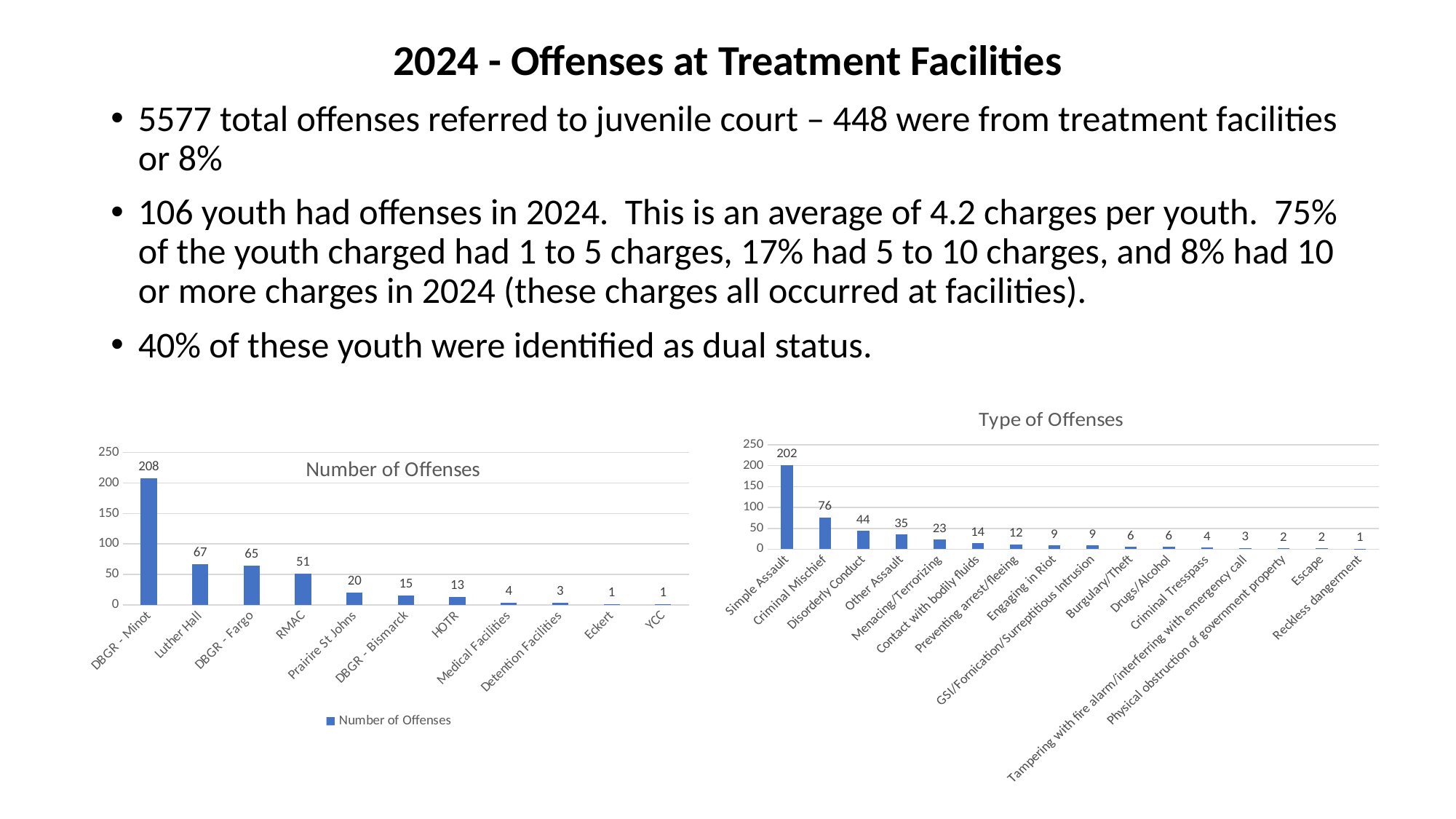
In the 'Type of Offenses' chart, which offense type has the lowest value? Reckless dangerment In the 'Number of Offenses' chart, which facility has the highest number of offenses? DBGR - Minot In the 'Number of Offenses' chart, how many series does the legend list? 1 In the 'Type of Offenses' chart, what is the difference between Simple Assault and Criminal Mischief? 126 In the 'Type of Offenses' chart, what is the value for Criminal Mischief? 76 In the 'Type of Offenses' chart, which is larger: Disorderly Conduct or Other Assault? Disorderly Conduct In the 'Number of Offenses' chart, how many facilities are shown on the x axis? 11 In the 'Number of Offenses' chart, what is the value for RMAC? 51 In the 'Type of Offenses' chart, what is the value for Menacing/Terrorizing? 23 In the 'Number of Offenses' chart, what is the value for DBGR - Minot? 208 In the 'Number of Offenses' chart, what is the difference between Luther Hall and DBGR - Fargo? 2 What kind of chart is the 'Type of Offenses' chart? Bar chart